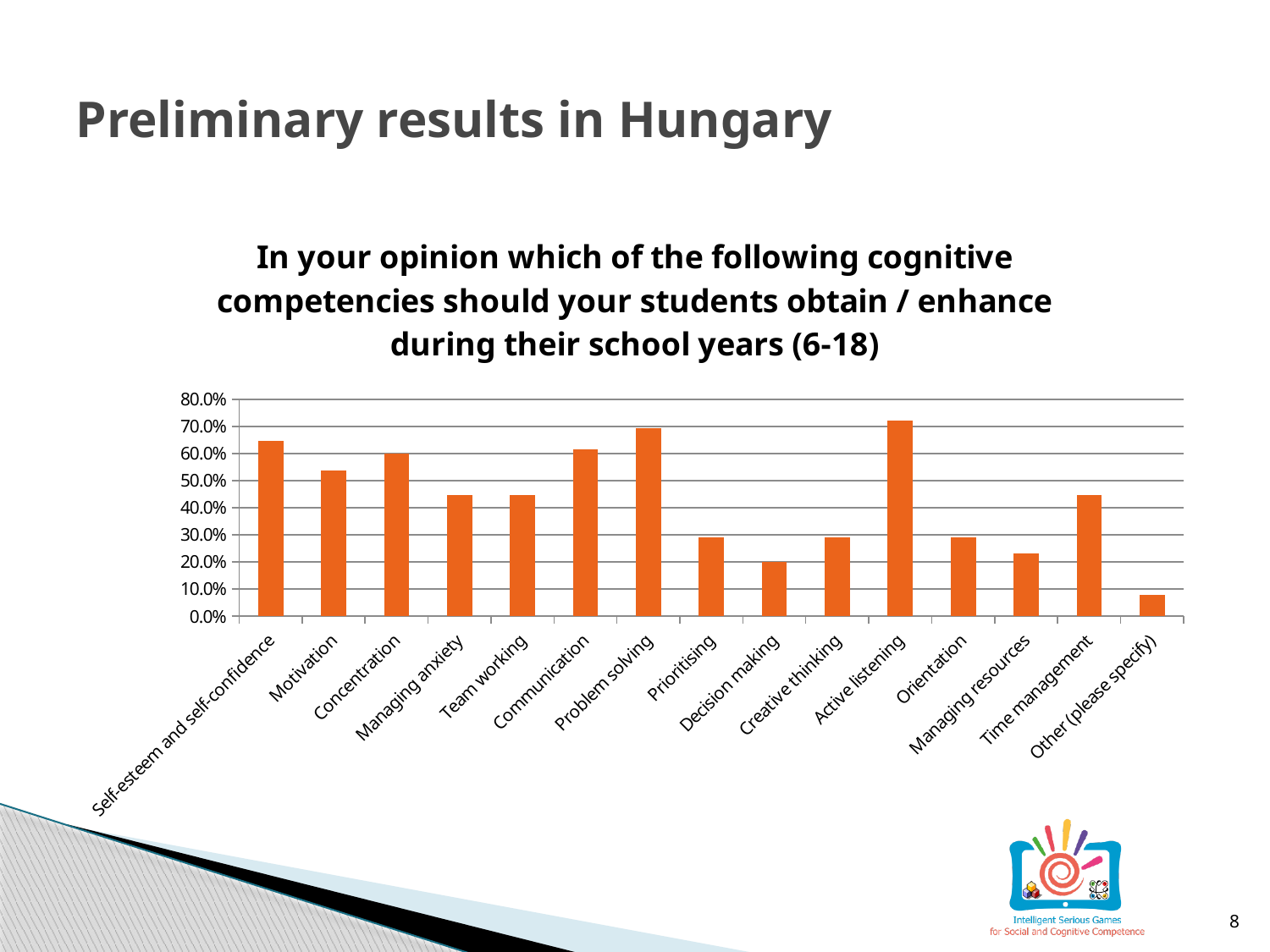
Which category has the highest value in the chart? Active listening Is the value for Active listening greater or less than 70.0%? greater Which is larger, the value for Managing resources or the value for Time management? Time management How many categories are shown on the x axis of the chart? 15 Is the value for Prioritising greater or less than 40.0%? less Is the value for Motivation greater or less than 50.0%? greater Which is larger, the value for Problem solving or the value for Decision making? Problem solving Which category has the lowest value in the chart? Other (please specify) What type of chart is shown on the slide? bar chart What colour are the bars in the chart? orange What is the highest value shown on the y axis of the chart? 80.0%